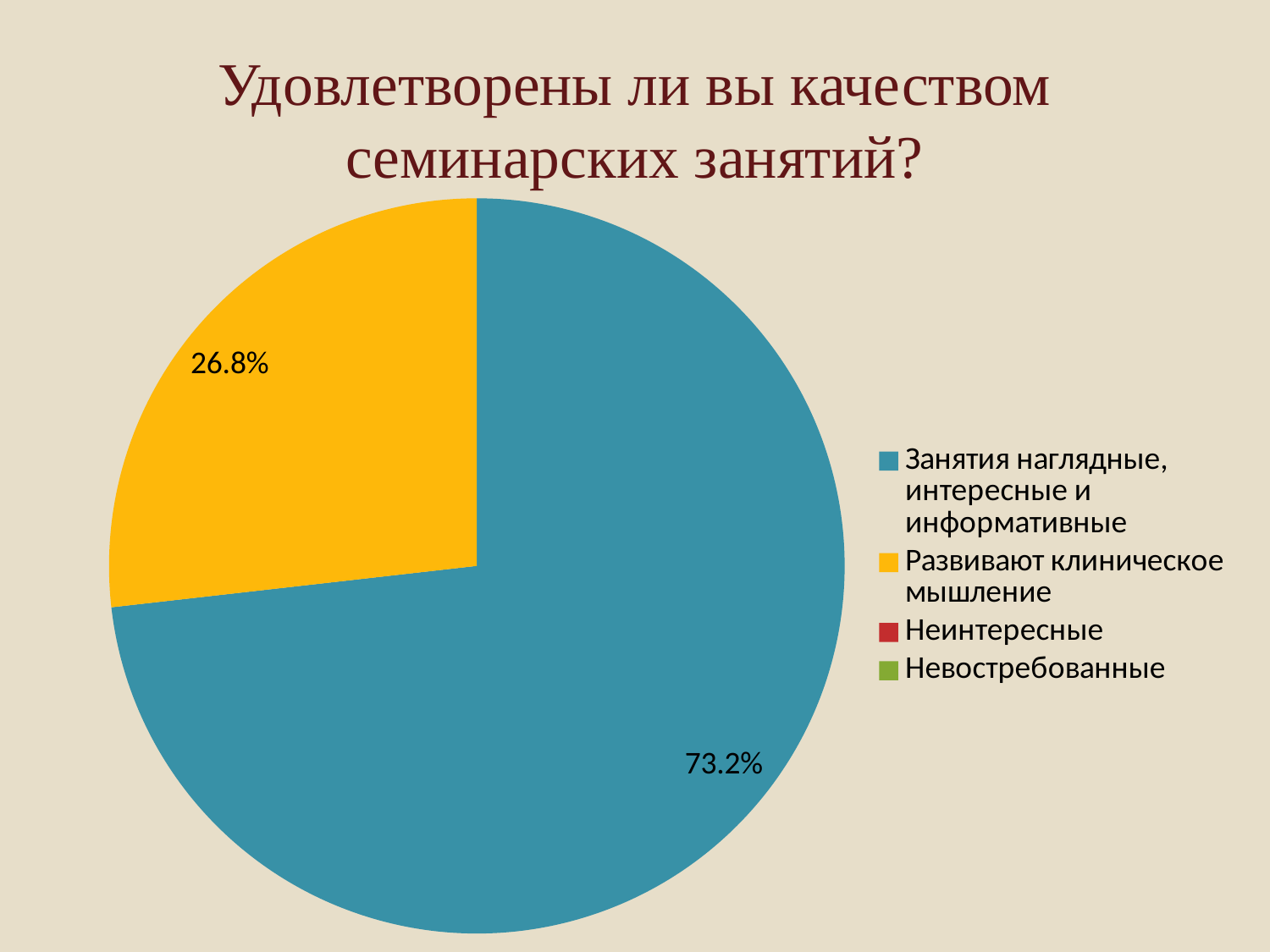
Is the share for 'Занятия наглядные, интересные и информативные' greater or less than 50%? greater What share of the pie is labelled for 'Занятия наглядные, интересные и информативные'? 73.2% Which category has the largest slice of the pie? Занятия наглядные, интересные и информативные What colour is the slice for 'Развивают клиническое мышление'? Yellow What is the difference in percentage points between the 'Занятия наглядные, интересные и информативные' slice and the 'Развивают клиническое мышление' slice? 46.4 What share of the pie is labelled for 'Развивают клиническое мышление'? 26.8% What is the title of the chart? Удовлетворены ли вы качеством семинарских занятий? How many slices are visible in the pie? 2 How many categories does the legend list? 4 What type of chart is shown on the slide? Pie chart Which is larger: the share for 'Развивают клиническое мышление' or the share for 'Занятия наглядные, интересные и информативные'? Занятия наглядные, интересные и информативные